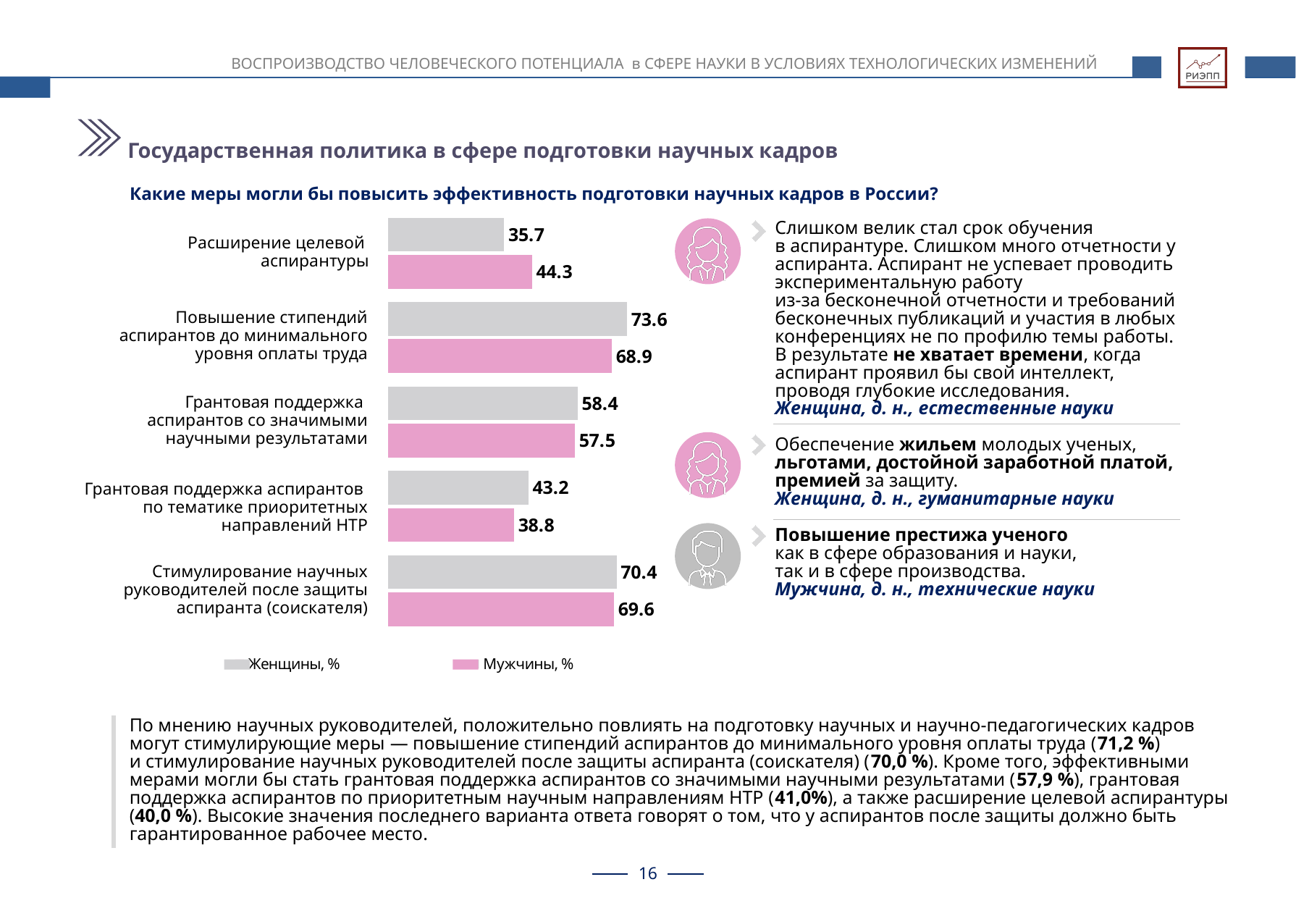
How many series does the chart legend list? 2 What is the difference between the 'Мужчины, %' and 'Женщины, %' values for 'Расширение целевой аспирантуры'? 8.6 What type of chart is shown on the slide? bar chart Which category has the lowest value for 'Мужчины, %'? Грантовая поддержка аспирантов по тематике приоритетных направлений НТР What is the value for 'Мужчины, %' for 'Грантовая поддержка аспирантов по тематике приоритетных направлений НТР'? 38.8 Which category has the highest value for 'Женщины, %'? Повышение стипендий аспирантов до минимального уровня оплаты труда Which colour represents the 'Мужчины, %' series in the chart? pink How many categories (measures) are shown in the chart? 5 What is the difference between the 'Женщины, %' and 'Мужчины, %' values for 'Повышение стипендий аспирантов до минимального уровня оплаты труда'? 4.7 What is the value for 'Женщины, %' for 'Расширение целевой аспирантуры'? 35.7 For 'Стимулирование научных руководителей после защиты аспиранта (соискателя)', which is larger: the 'Женщины, %' value or the 'Мужчины, %' value? Женщины, % What is the value for 'Мужчины, %' for 'Повышение стипендий аспирантов до минимального уровня оплаты труда'? 68.9